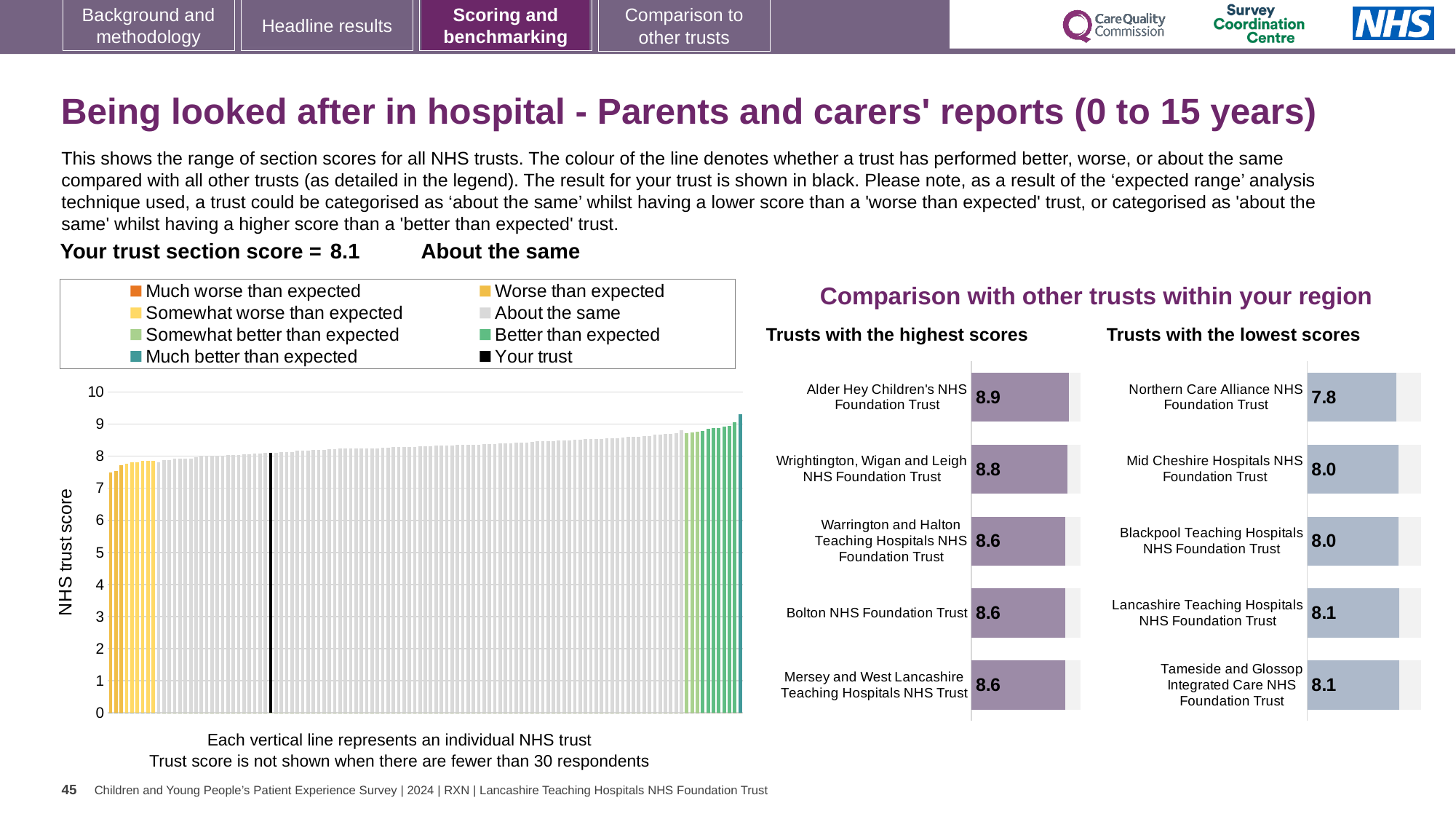
What kind of chart is the large chart on the left showing all NHS trusts? Bar chart How many trusts are listed in the 'Trusts with the highest scores' chart? 5 In the large chart on the left, is the value for your trust (the black line) greater or less than 5? greater In the 'Trusts with the lowest scores' chart, which trust has the lowest score? Northern Care Alliance NHS Foundation Trust How many entries does the legend of the large chart on the left list? 8 In the 'Trusts with the highest scores' chart, what is the score for Wrightington, Wigan and Leigh NHS Foundation Trust? 8.8 In the 'Trusts with the highest scores' chart, what is the difference between the scores of Alder Hey Children's NHS Foundation Trust and Bolton NHS Foundation Trust? 0.3 In the 'Trusts with the highest scores' chart, which trust has the highest score? Alder Hey Children's NHS Foundation Trust In the 'Trusts with the lowest scores' chart, what is the score for Tameside and Glossop Integrated Care NHS Foundation Trust? 8.1 In the 'Trusts with the lowest scores' chart, what is the score for Northern Care Alliance NHS Foundation Trust? 7.8 In the 'Trusts with the lowest scores' chart, which has the larger score: Mid Cheshire Hospitals NHS Foundation Trust or Lancashire Teaching Hospitals NHS Foundation Trust? Lancashire Teaching Hospitals NHS Foundation Trust In the 'Trusts with the highest scores' chart, what is the score for Alder Hey Children's NHS Foundation Trust? 8.9